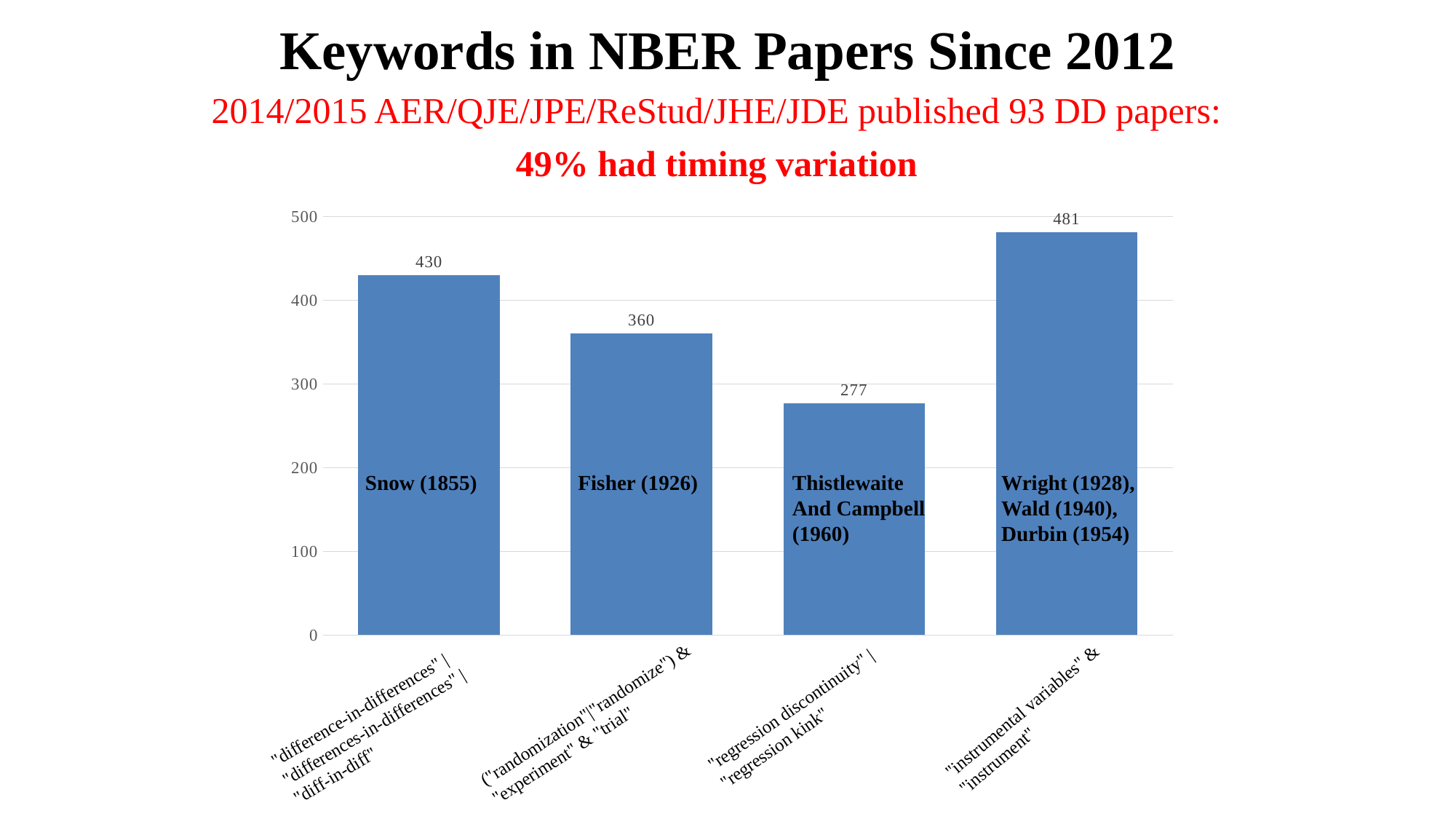
How many keyword categories are shown in the chart? 4 What is the difference between the randomization bar and the regression discontinuity bar? 83 Which keyword category has the lowest count? regression discontinuity What is the value for the regression discontinuity keyword bar? 277 Which author label is printed inside the regression discontinuity bar? Thistlewaite And Campbell (1960) What is the difference between the instrumental variables bar and the difference-in-differences bar? 51 What is the value for the instrumental variables keyword bar? 481 Which keyword category has the highest count? instrumental variables What is the value for the randomization/experiment keyword bar? 360 What is the value for the difference-in-differences keyword bar? 430 What kind of chart is shown on the slide? bar chart Which is larger, the difference-in-differences bar or the randomization bar? difference-in-differences